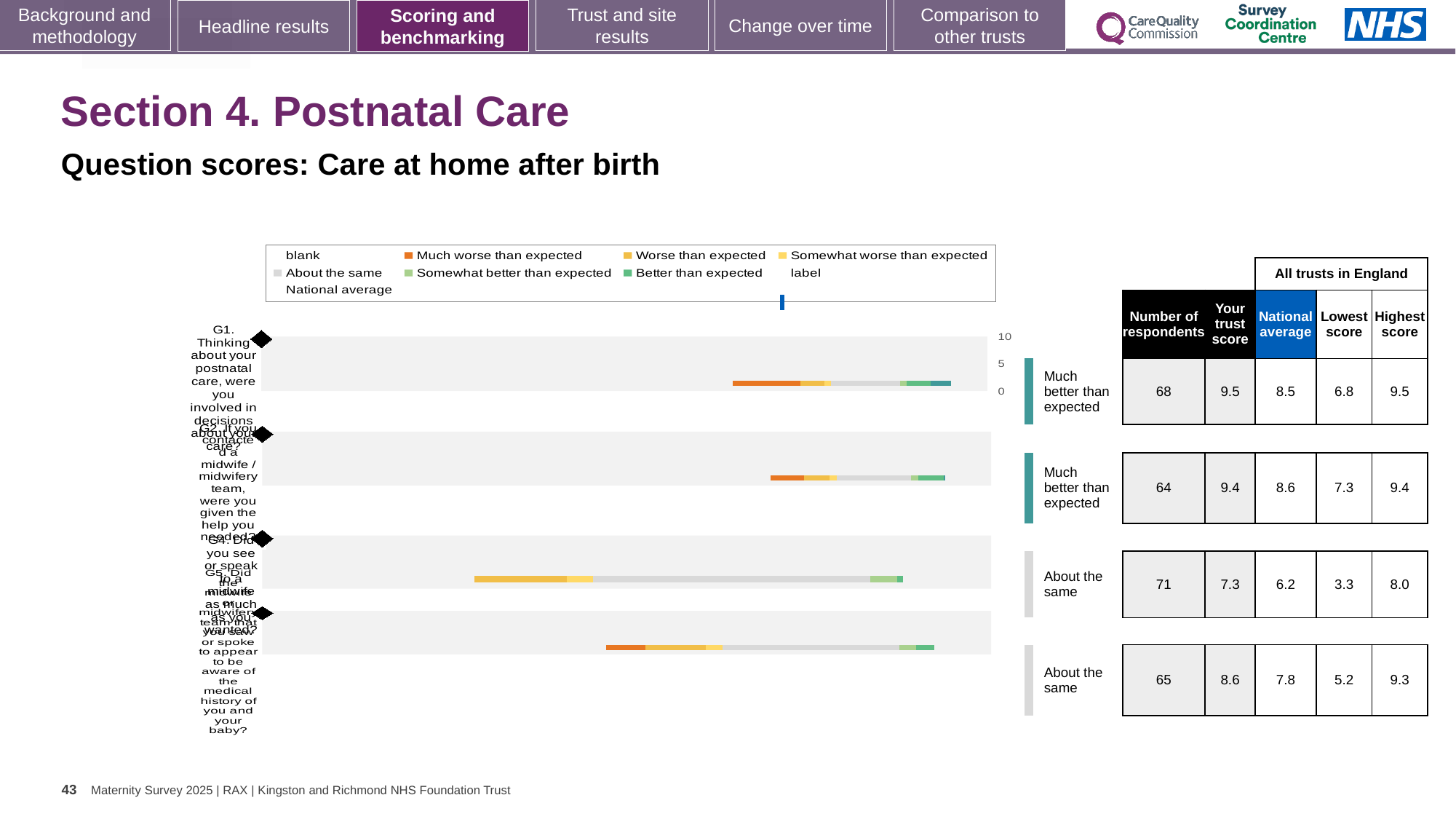
Which question has the lowest trust score? G4 What is the trust score for question G2 (given the help you needed when contacting a midwife)? 9.4 What is the lowest score among all trusts in England for question G5 (midwife aware of medical history)? 5.2 What is the highest score among all trusts in England for question G1? 9.5 Which question has the highest number of respondents? G4 What kind of chart is shown on the slide? Bar chart What benchmark category is shown for question G1? Much better than expected What is the national average for question G4 (see or speak to a midwife as much as you wanted)? 6.2 For question G2, which is larger: the trust score or the national average? Trust score What is the difference between the trust score and the national average for question G1? 1.0 How many questions are plotted in the chart? 4 How many respondents answered question G1 (involved in decisions about postnatal care)? 68